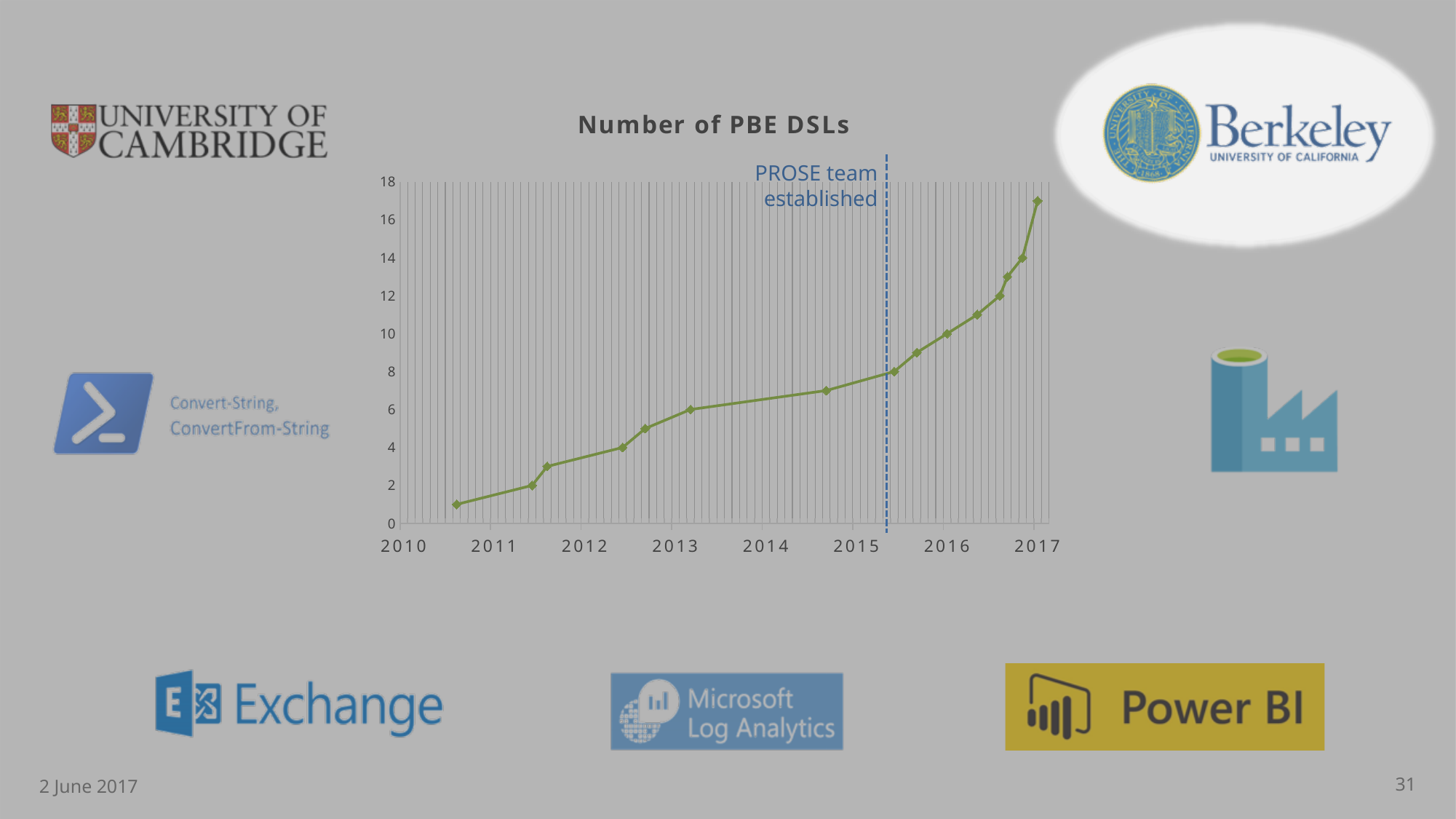
What event does the dashed vertical line in the chart mark? PROSE team established What is the highest value shown on the y axis? 18 What kind of chart is shown on the slide? line chart Is the value of the data point at 2017 larger or smaller than the value of the data point at 2016? larger Is the value of the last data point (at 2017) greater or less than 16? greater Is the value of the data point at 2016 greater or less than 8? greater Is the value of the first data point (between 2010 and 2011) greater or less than 2? less Which year on the x axis has the highest value in the chart? 2017 What is the title of the chart? Number of PBE DSLs Do the values in the chart rise or fall from 2010 to 2017? rise How many year labels are shown on the x axis? 8